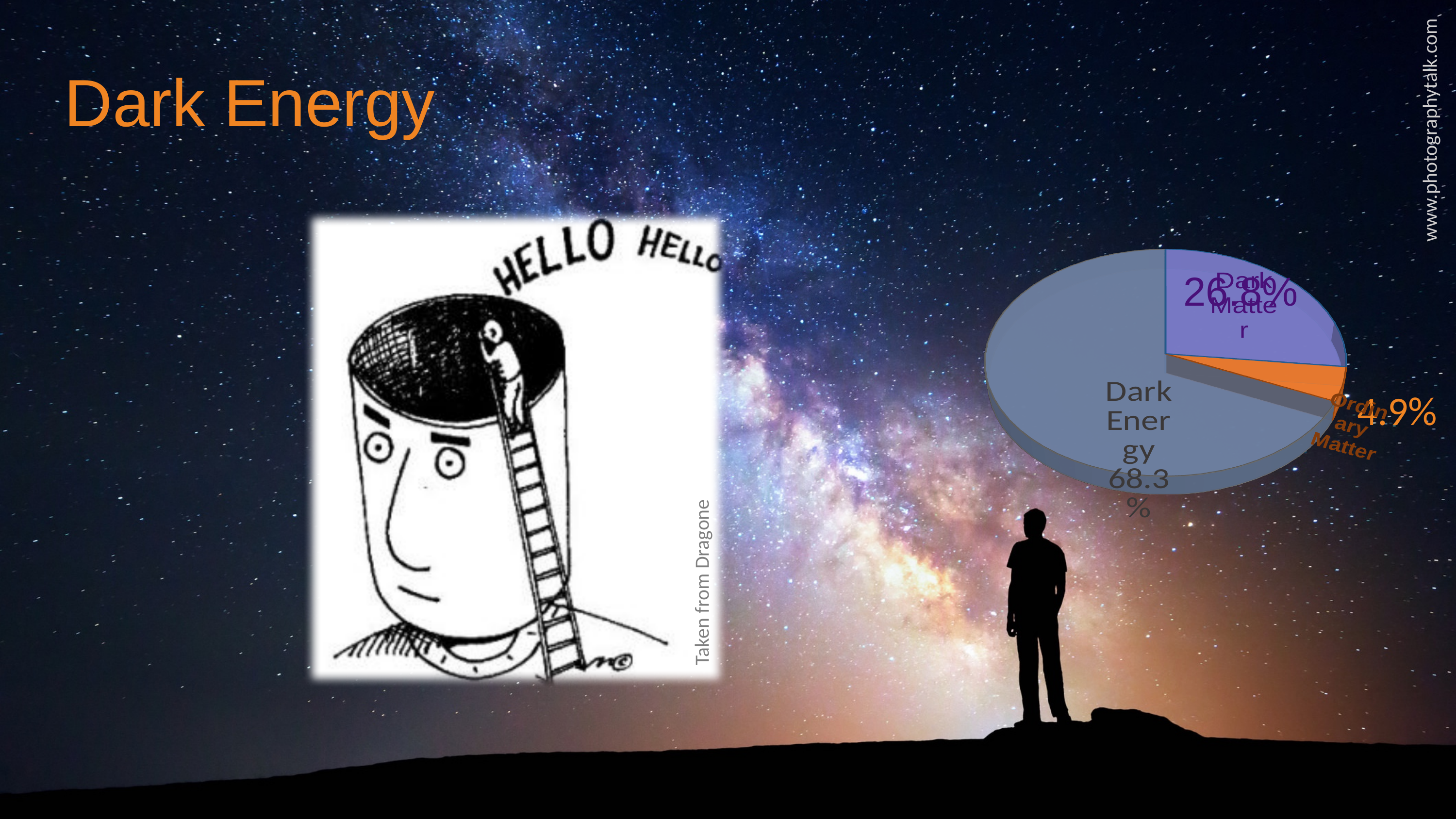
How many slices does the pie chart have? 3 Which slice of the pie chart is the smallest? Ordinary Matter What kind of chart is shown on the slide? pie chart What share of the pie does the Dark Energy slice represent? 68.3% What is the difference in percentage points between Dark Energy and Dark Matter in the pie chart? 41.5 Which slice of the pie chart is the largest? Dark Energy What percentage does the pie chart show for Ordinary Matter? 4.9% What is the difference in percentage points between Dark Matter and Ordinary Matter in the pie chart? 21.9 What colour is the Ordinary Matter slice in the pie chart? orange What percentage does the pie chart show for Dark Matter? 26.8% Which is larger in the pie chart, Dark Matter or Ordinary Matter? Dark Matter What percentage does the pie chart show for Dark Energy? 68.3%